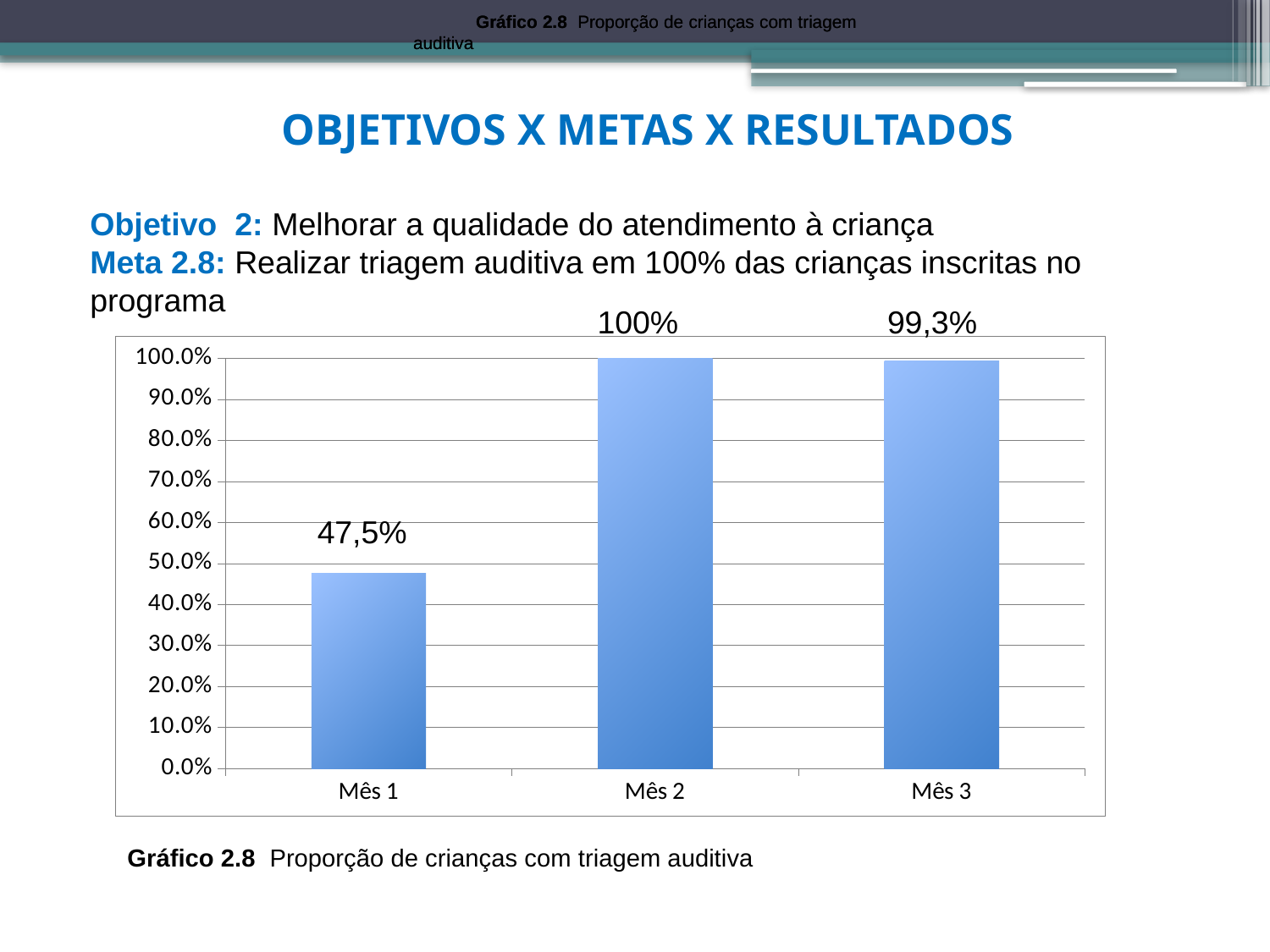
What is the difference between the values for Mês 2 and Mês 1? 52,5% Which month has the highest value? Mês 2 How many categories are shown on the x axis? 3 Which is larger, the value for Mês 1 or the value for Mês 3? Mês 3 What is the caption of the chart shown below it? Gráfico 2.8 Proporção de crianças com triagem auditiva Which month has the lowest value? Mês 1 What is the value for Mês 3? 99,3% Is the value for Mês 1 greater or less than 50.0%? less What is the value for Mês 2? 100% Does the value rise or fall from Mês 1 to Mês 2? rise What kind of chart is shown on the slide? bar chart What is the value for Mês 1? 47,5%